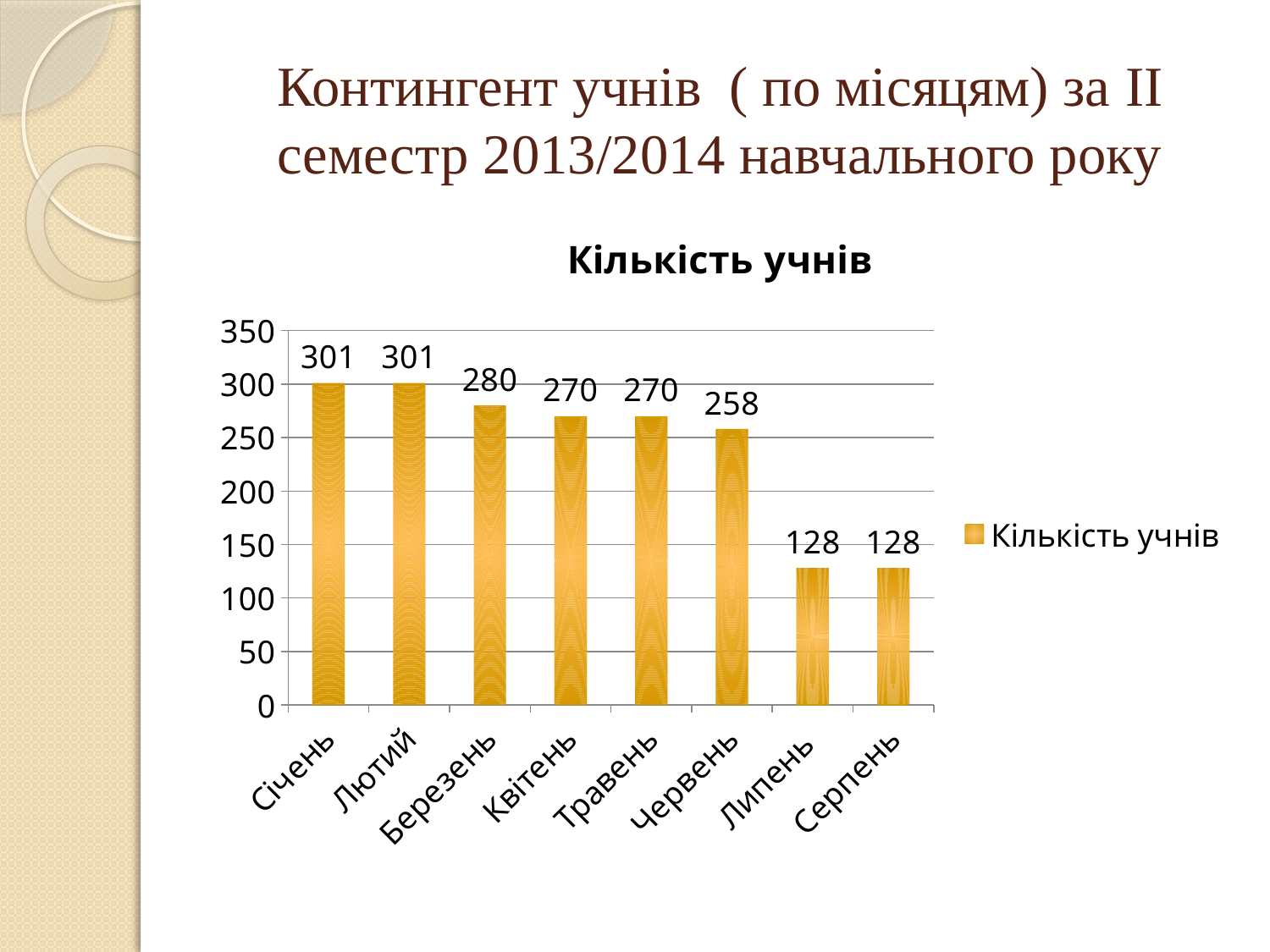
Which month has the lowest value? Липень and Серпень (128) What is the value for Березень? 280 What is the difference between the values for Березень and Червень? 22 What is the difference between the values for Лютий and Серпень? 173 What kind of chart is shown? bar chart Which is larger, the value for Квітень or the value for Червень? Квітень How many months are shown on the x axis? 8 What is the value for Червень? 258 What is the value for Січень? 301 Do the values rise or fall from Січень to Серпень? fall How many series does the legend list? 1 What is the value for Липень? 128